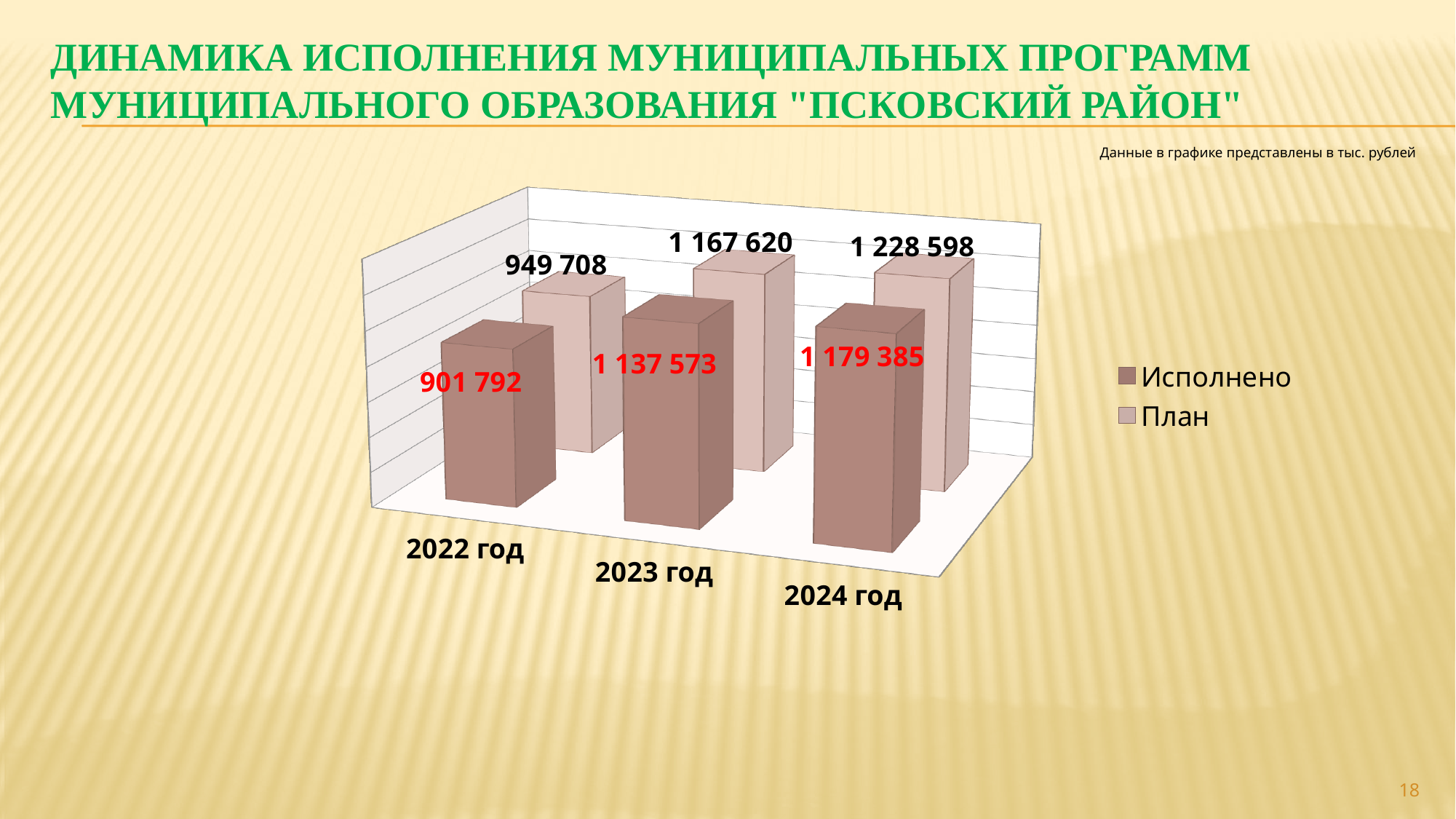
Which year has the highest Исполнено value? 2024 год What is the difference between План and Исполнено for 2022 год? 47 916 Does the Исполнено value rise or fall from 2022 год to 2024 год? rise What is the difference between План and Исполнено for 2024 год? 49 213 What is the value of Исполнено for 2022 год? 901 792 What is the value of Исполнено for 2024 год? 1 179 385 What is the value of План for 2023 год? 1 167 620 Which year has the lowest План value? 2022 год How many years are shown on the x axis? 3 Which is larger for 2023 год: Исполнено or План? План How many series does the legend list? 2 What is the value of План for 2024 год? 1 228 598